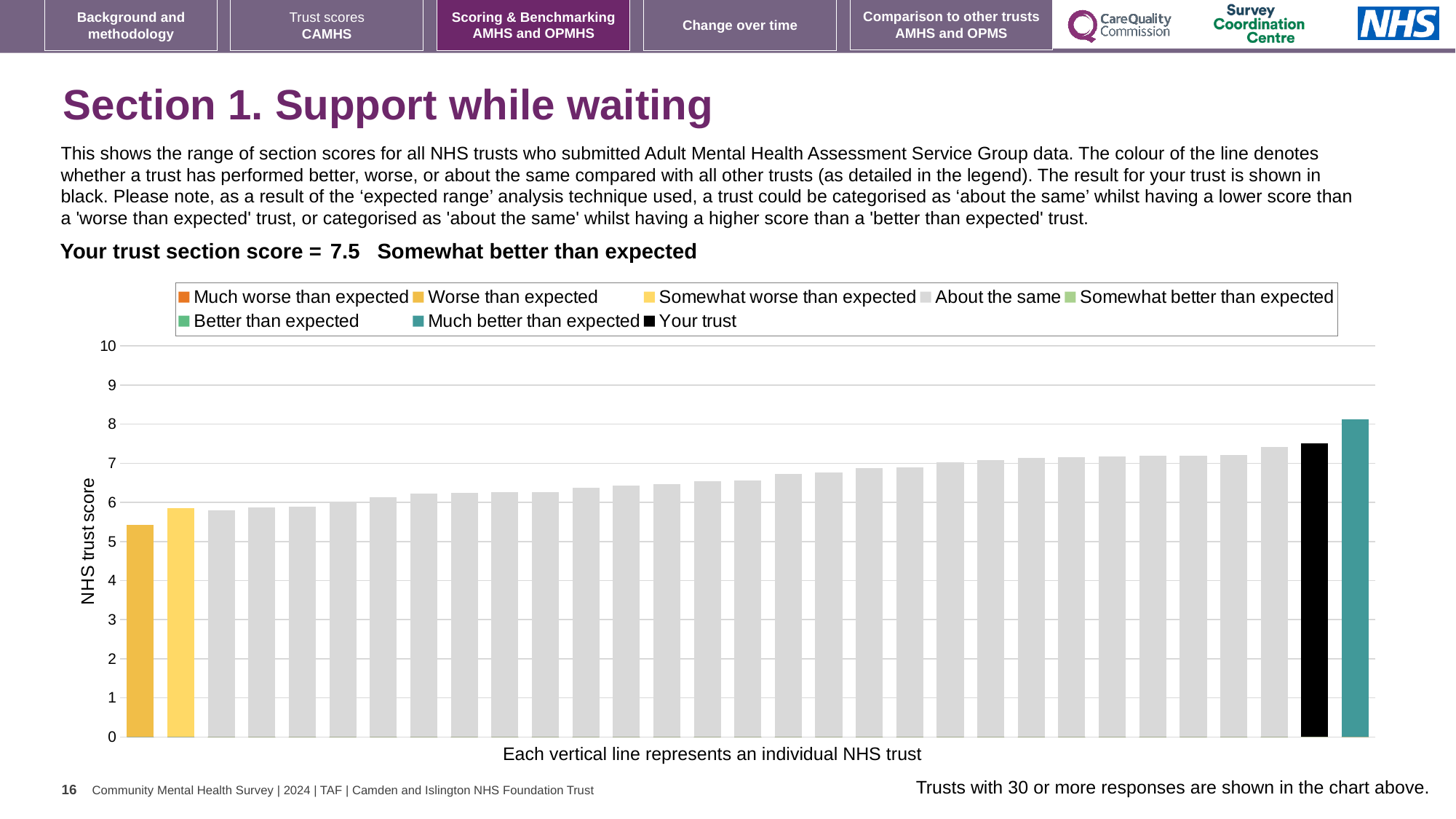
Is the value for your trust (the black bar) greater or less than 7? greater What is the highest value shown on the vertical axis? 10 Which legend category does the shortest bar in the chart belong to? Worse than expected Do the bar values rise or fall from left to right across the chart? rise Is the value of the shortest (leftmost) bar greater or less than 6? less Is the value of the tallest bar greater or less than 8? greater How many entries does the chart legend list? 8 What kind of chart is shown on the slide? bar chart Which is larger: the score for your trust (black bar) or the score of the leftmost bar? your trust (black bar) Which legend category does the tallest bar in the chart belong to? Much better than expected What is the label on the vertical axis of the chart? NHS trust score What is the section score for your trust (the black bar)? 7.5